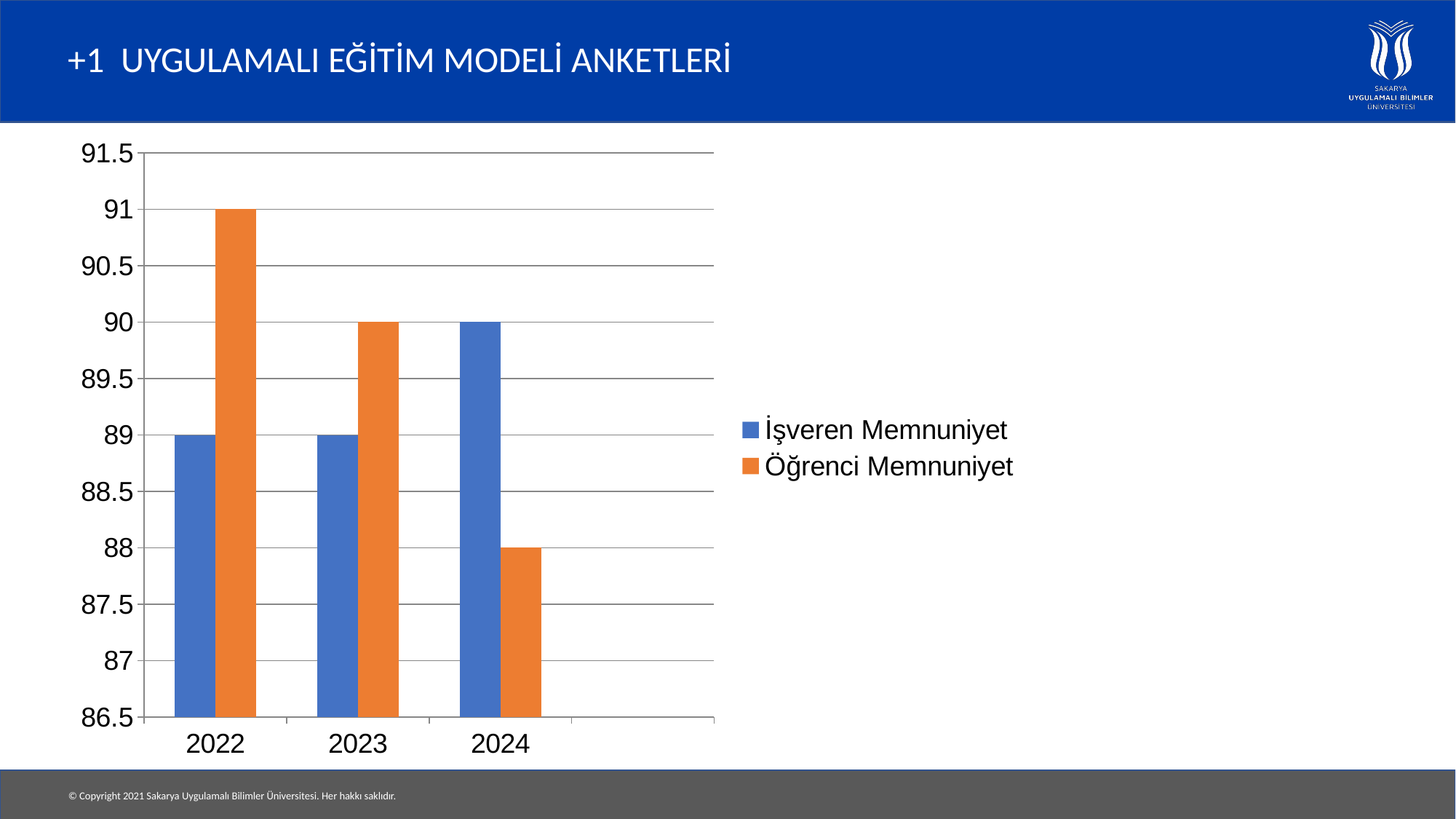
Which colour represents Öğrenci Memnuniyet in the legend? orange Does Öğrenci Memnuniyet rise or fall from 2022 to 2024? fall How many series does the legend list? 2 What is the value of Öğrenci Memnuniyet for 2022? 91 What kind of chart is shown on the slide? bar chart In which year is Öğrenci Memnuniyet lowest? 2024 What is the difference between Öğrenci Memnuniyet and İşveren Memnuniyet in 2022? 2 What is the value of Öğrenci Memnuniyet for 2024? 88 What is the value of İşveren Memnuniyet for 2024? 90 Which is larger in 2024, İşveren Memnuniyet or Öğrenci Memnuniyet? İşveren Memnuniyet In which year is Öğrenci Memnuniyet highest? 2022 How many years are shown on the x axis? 3